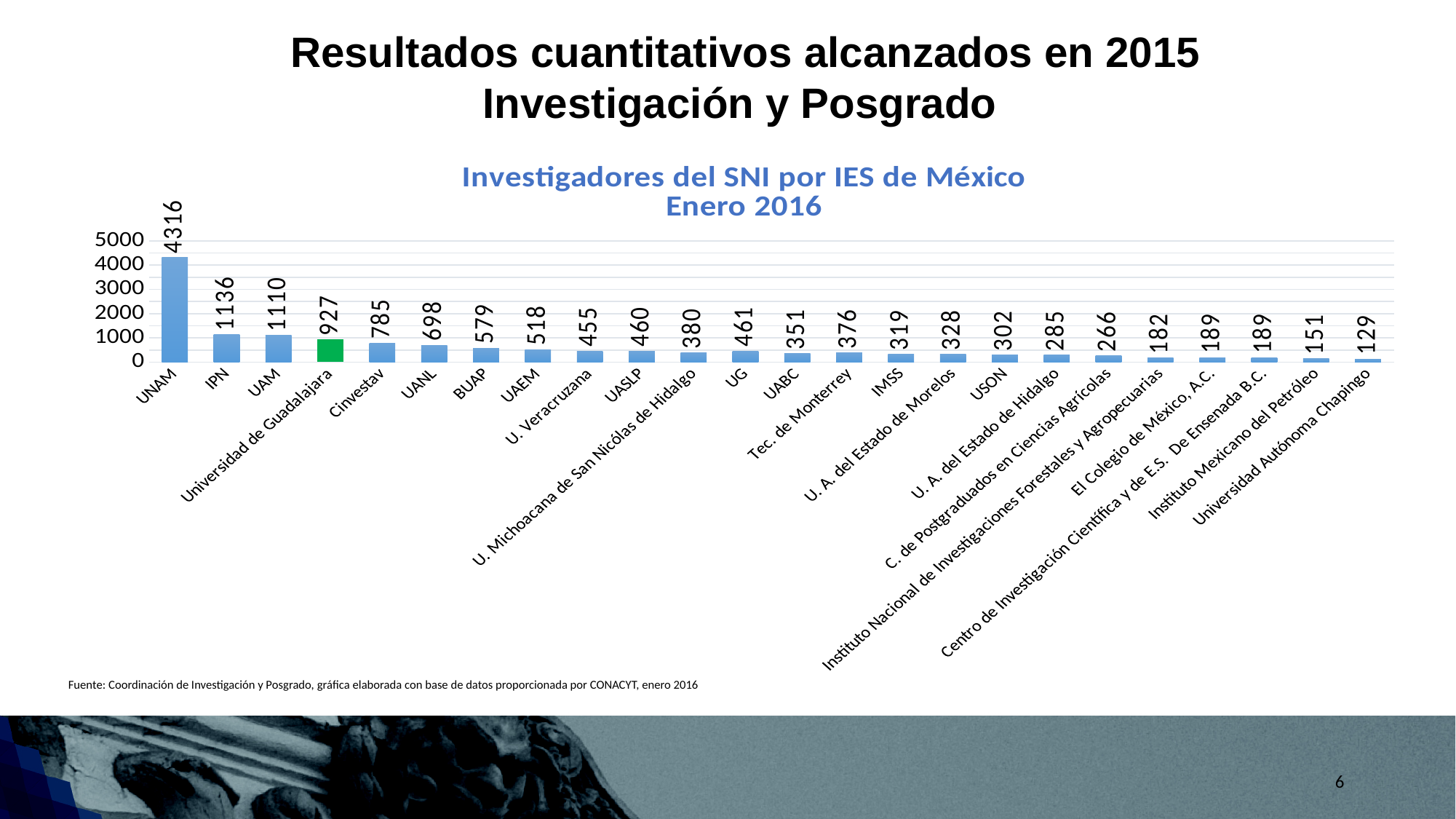
What is the value for Cinvestav? 785 Which institution has the lowest number of SNI researchers? Universidad Autónoma Chapingo What is the difference between the values for UNAM and IPN? 3180 What is the value for Universidad de Guadalajara? 927 What is the value for UNAM? 4316 What kind of chart is shown on the slide? Bar chart How many institutions are shown on the chart? 24 Which institution's bar is coloured green instead of blue? Universidad de Guadalajara What is the difference between the values for IPN and UAM? 26 Which is larger, the value for BUAP or the value for UAEM? BUAP What is the value for Tec. de Monterrey? 376 Which institution has the highest number of SNI researchers? UNAM